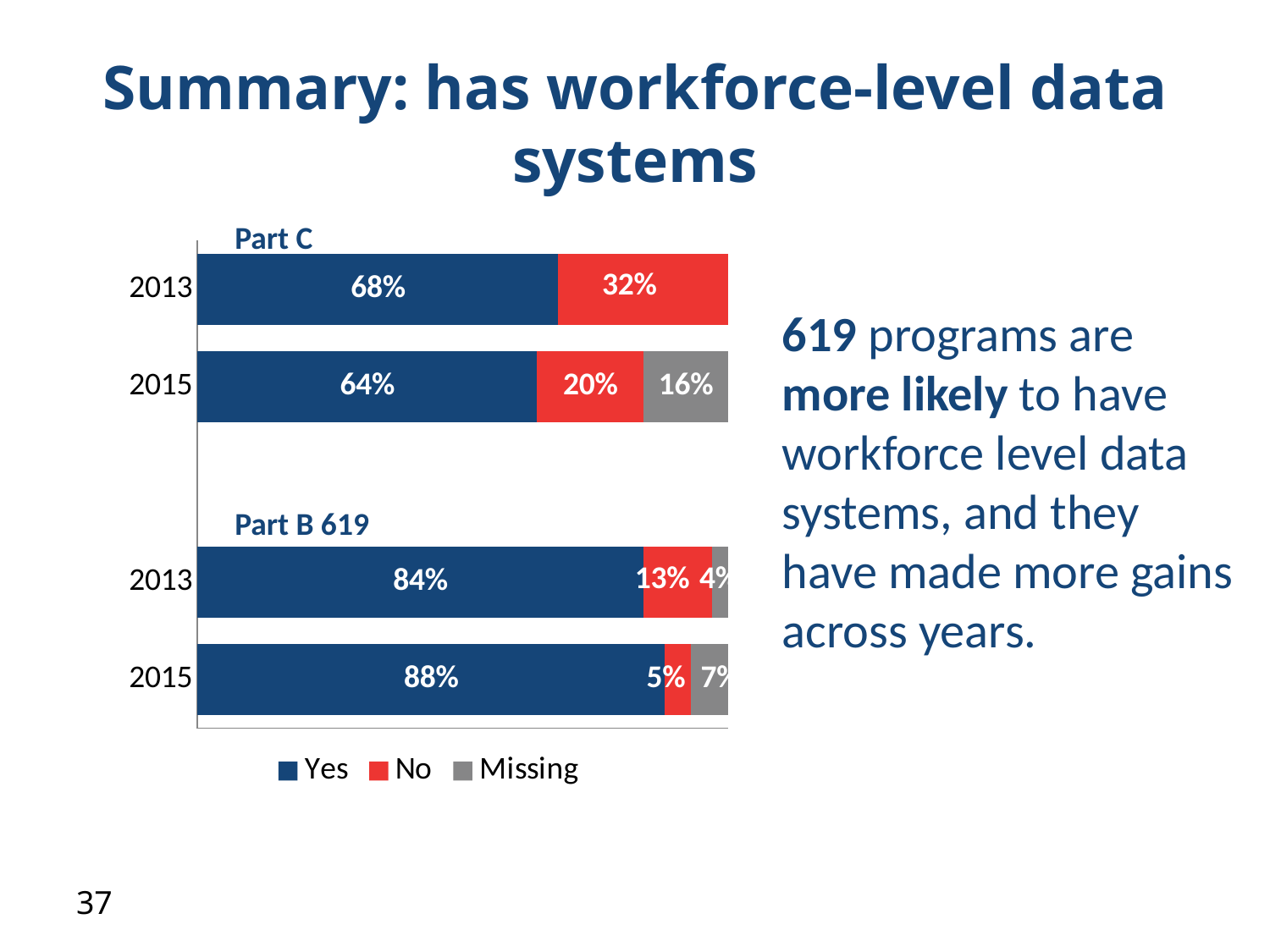
What kind of chart is shown on the slide? Stacked bar chart What is the No share for Part B 619 in 2013? 13% What is the difference between the No share for Part C in 2013 and in 2015? 12 percentage points Which is larger: the Yes share for Part C in 2013 or the Yes share for Part B 619 in 2013? Part B 619 in 2013 Which bar has the highest Yes percentage? Part B 619, 2015 How many series does the legend list? 3 By how many percentage points did the Yes share for Part B 619 change from 2013 to 2015? 4 percentage points What percentage of Part B 619 programs answered Yes in 2015? 88% What is the Missing share for Part C in 2015? 16% Which colour represents the Missing series in the chart? Grey Which bar has the lowest Yes percentage? Part C, 2015 What percentage of Part C programs answered Yes in 2013? 68%